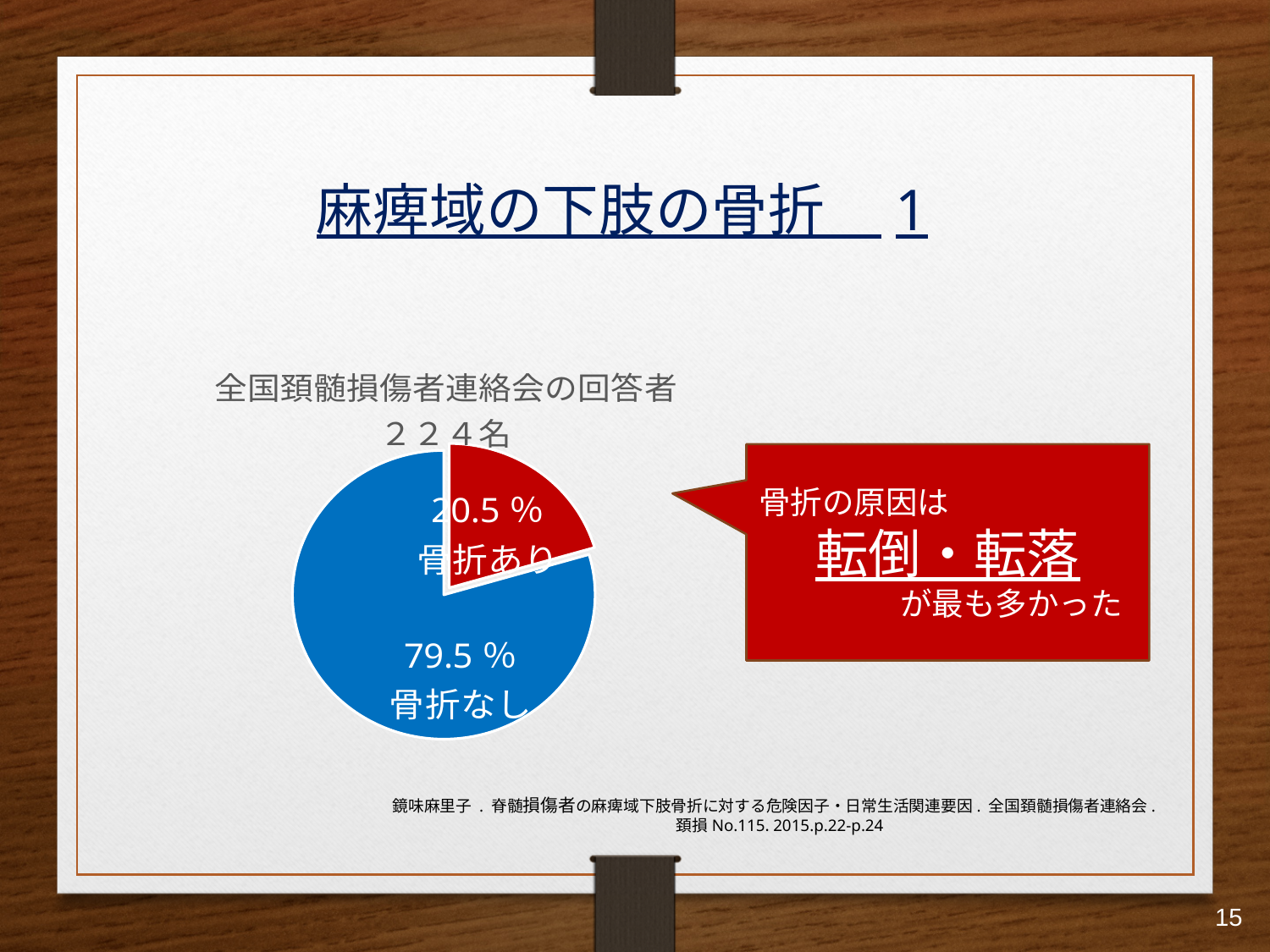
What percentage of respondents are in the 骨折なし slice? 79.5 % What colour is the 骨折あり slice of the pie chart? Red Which slice of the pie chart is the largest? 骨折なし What percentage of respondents are in the 骨折あり slice? 20.5 % What is the difference in percentage points between the 骨折なし and 骨折あり slices? 59 percentage points How many slices does the pie chart have? 2 Which is larger, the 骨折あり slice or the 骨折なし slice? 骨折なし Which slice of the pie chart is the smallest? 骨折あり What share of the pie does the 骨折あり slice represent? 20.5 % What kind of chart is shown on the slide? Pie chart How many respondents does the chart's heading say were surveyed? 224名